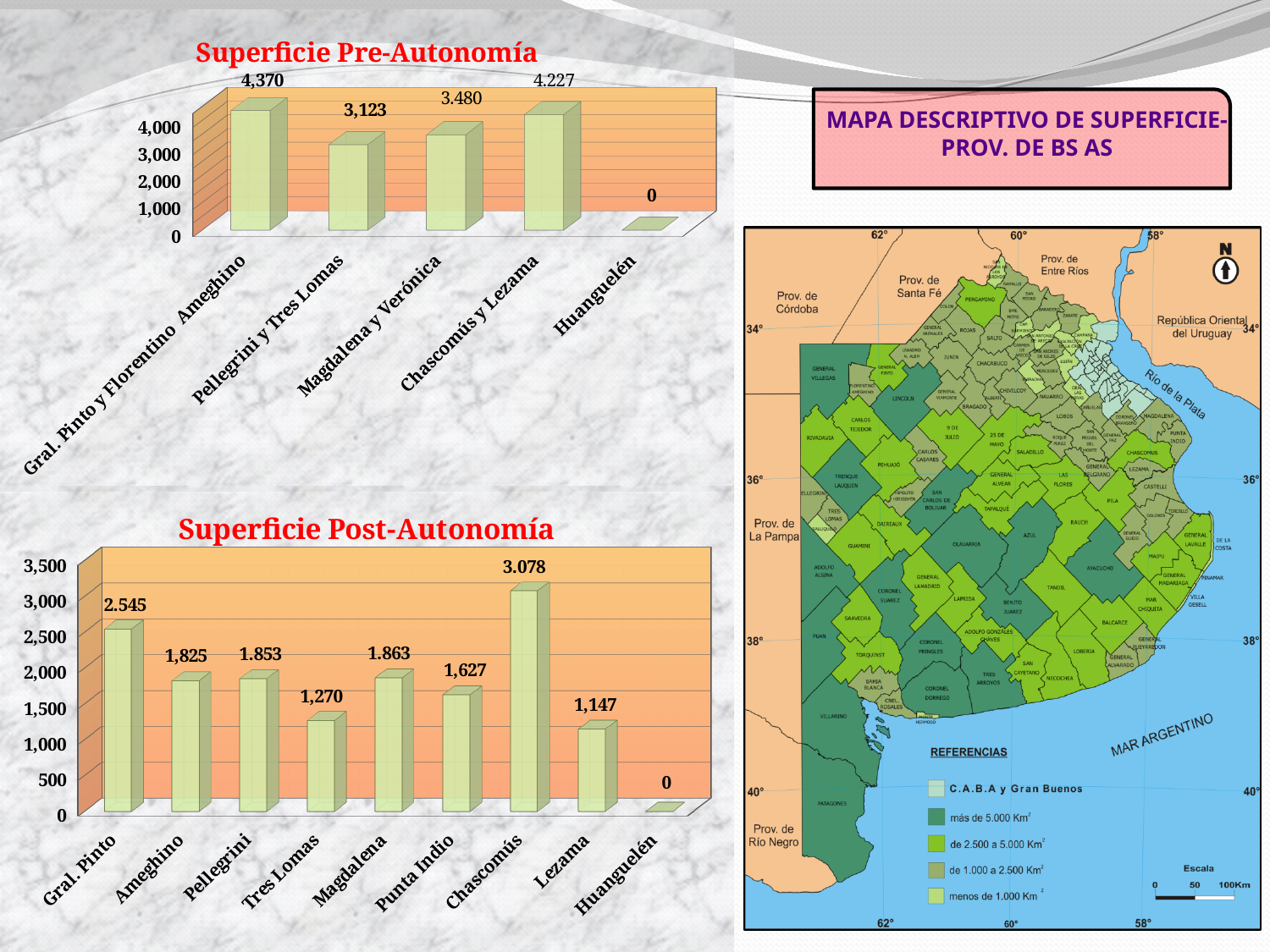
In the Superficie Post-Autonomía chart, what is the value for Chascomús? 3.078 In the Superficie Post-Autonomía chart, which category has the lowest value? Huanguelén In the Superficie Pre-Autonomía chart, what is the difference between Gral. Pinto y Florentino Ameghino and Pellegrini y Tres Lomas? 1,247 In the Superficie Post-Autonomía chart, what is the value for Punta Indio? 1,627 In the Superficie Post-Autonomía chart, which is larger, Gral. Pinto or Lezama? Gral. Pinto How many categories are shown in the Superficie Post-Autonomía chart? 9 What kind of chart is the Superficie Post-Autonomía chart? Bar chart How many categories are shown in the Superficie Pre-Autonomía chart? 5 In the Superficie Pre-Autonomía chart, which category has the highest value? Gral. Pinto y Florentino Ameghino In the Superficie Pre-Autonomía chart, what is the value for Gral. Pinto y Florentino Ameghino? 4,370 In the Superficie Pre-Autonomía chart, what is the value for Magdalena y Verónica? 3.480 In the Superficie Post-Autonomía chart, what is the difference between Ameghino and Tres Lomas? 555